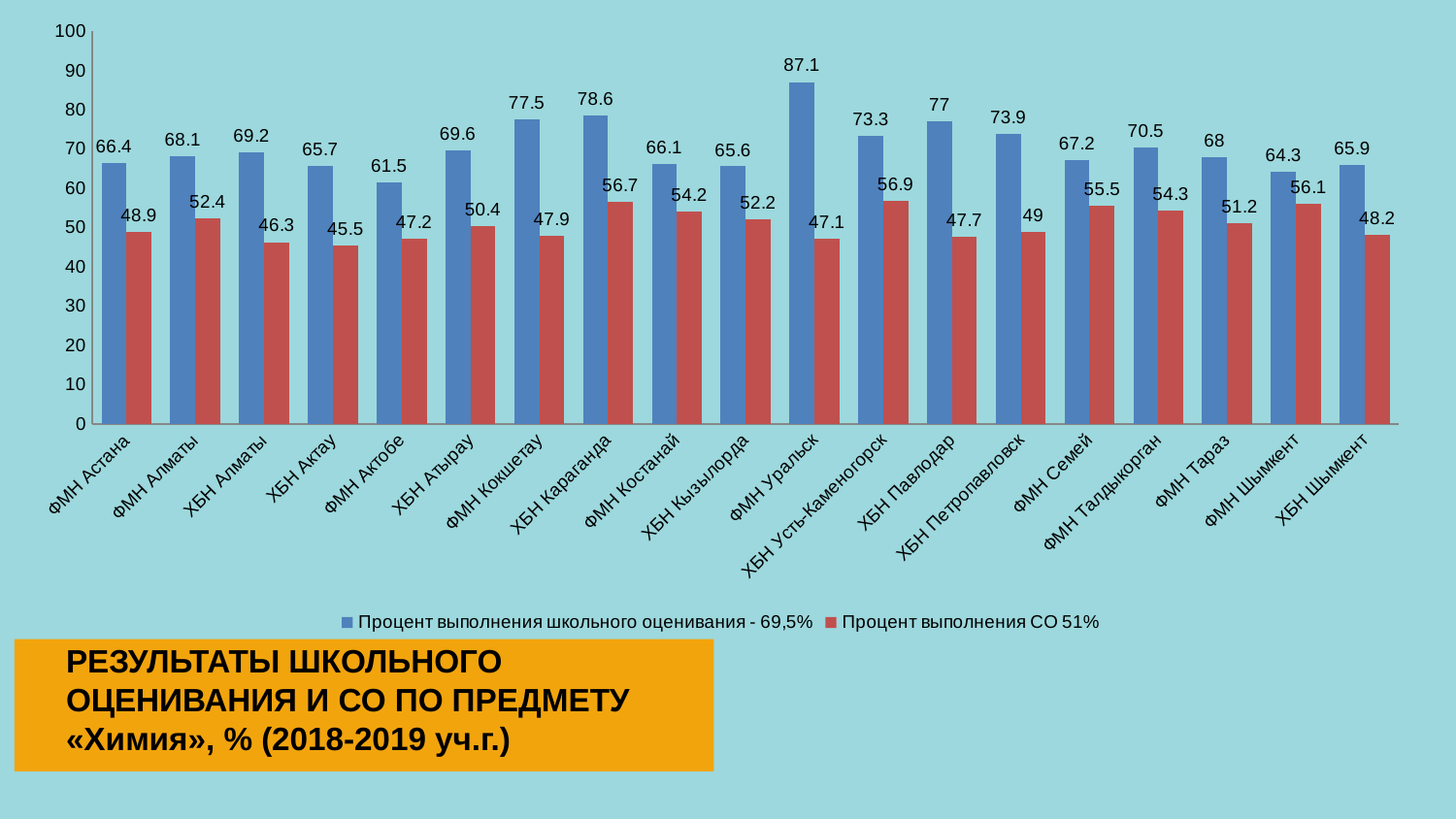
What is the СО completion percentage (red series) for ХБН Караганда? 56.7 Which category has the highest school assessment completion percentage (blue series)? ФМН Уральск What kind of chart is shown on the slide? bar chart What is the СО completion value for ФМН Шымкент? 56.1 Which category has the lowest school assessment completion percentage (blue series)? ФМН Актобе How many series does the legend list? 2 What is the school assessment completion value for ФМН Актобе? 61.5 What is the school assessment completion percentage (blue series) for ФМН Уральск? 87.1 How many categories (schools) are shown on the x axis? 19 What is the difference between the school assessment value and the СО value for ФМН Уральск? 40 Is the СО completion value for ХБН Актау greater or less than 50? less Which is larger for ХБН Павлодар: the school assessment value or the СО value? the school assessment value (77)